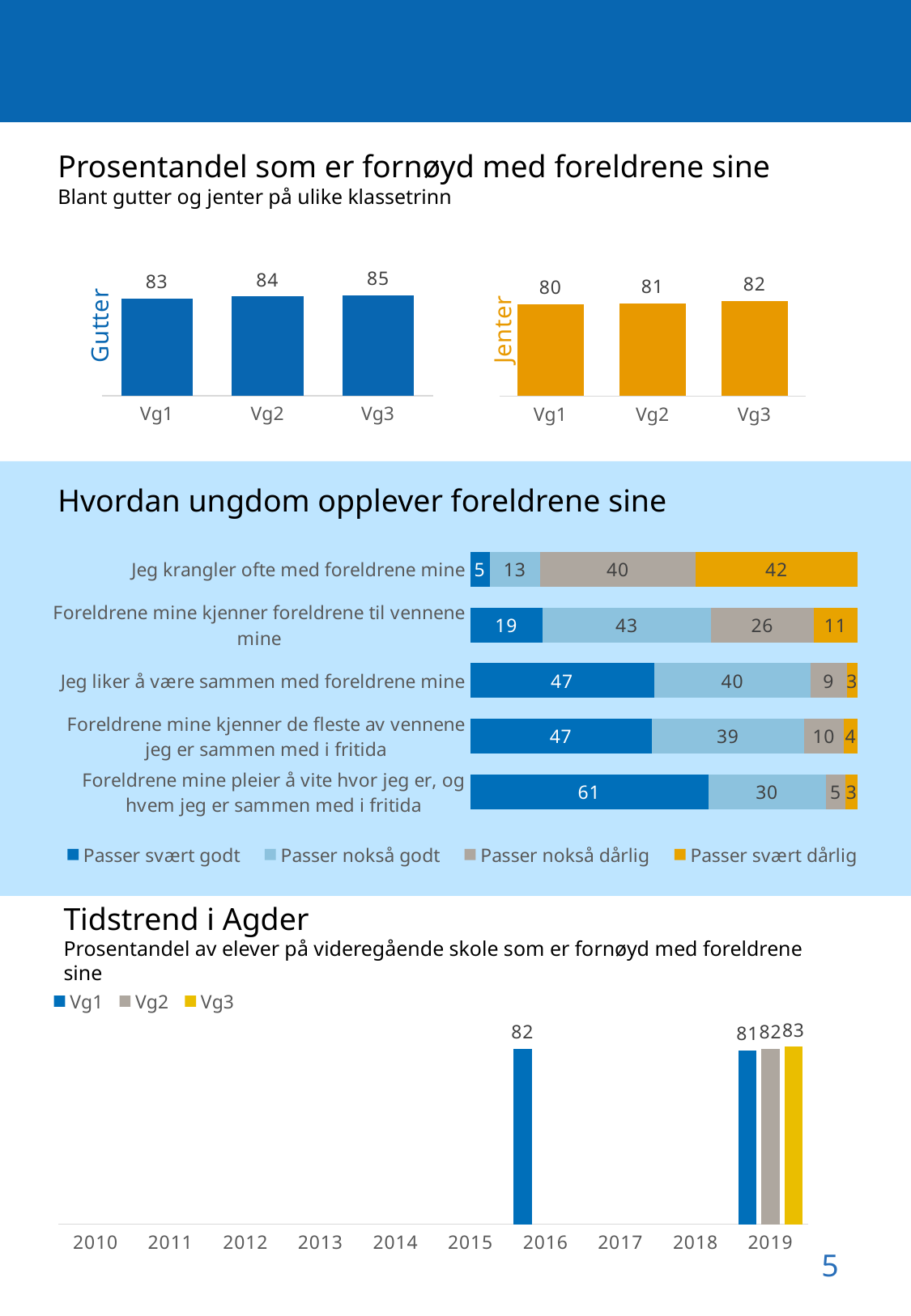
What is the difference between the Vg2 value in the 'Gutter' chart and the Vg2 value in the 'Jenter' chart? 3 In the 'Gutter' chart, what is the value for Vg3? 85 In the 'Hvordan ungdom opplever foreldrene sine' chart, what is the 'Passer svært godt' value for 'Jeg krangler ofte med foreldrene mine'? 5 What kind of chart is the 'Tidstrend i Agder' chart? Bar chart In the 'Hvordan ungdom opplever foreldrene sine' chart, how many series does the legend list? 4 In the 'Gutter' chart, which category has the lowest value? Vg1 In the 'Hvordan ungdom opplever foreldrene sine' chart, what is the 'Passer nokså godt' value for 'Foreldrene mine kjenner foreldrene til vennene mine'? 43 In the 'Hvordan ungdom opplever foreldrene sine' chart, which statement has the highest 'Passer svært godt' value? Foreldrene mine pleier å vite hvor jeg er, og hvem jeg er sammen med i fritida In the 'Jenter' chart, what is the value for Vg1? 80 In the 'Hvordan ungdom opplever foreldrene sine' chart, how many statements (categories) are shown? 5 In the 'Tidstrend i Agder' chart, what is the Vg3 value for 2019? 83 In the 'Jenter' chart, which category has the highest value? Vg3